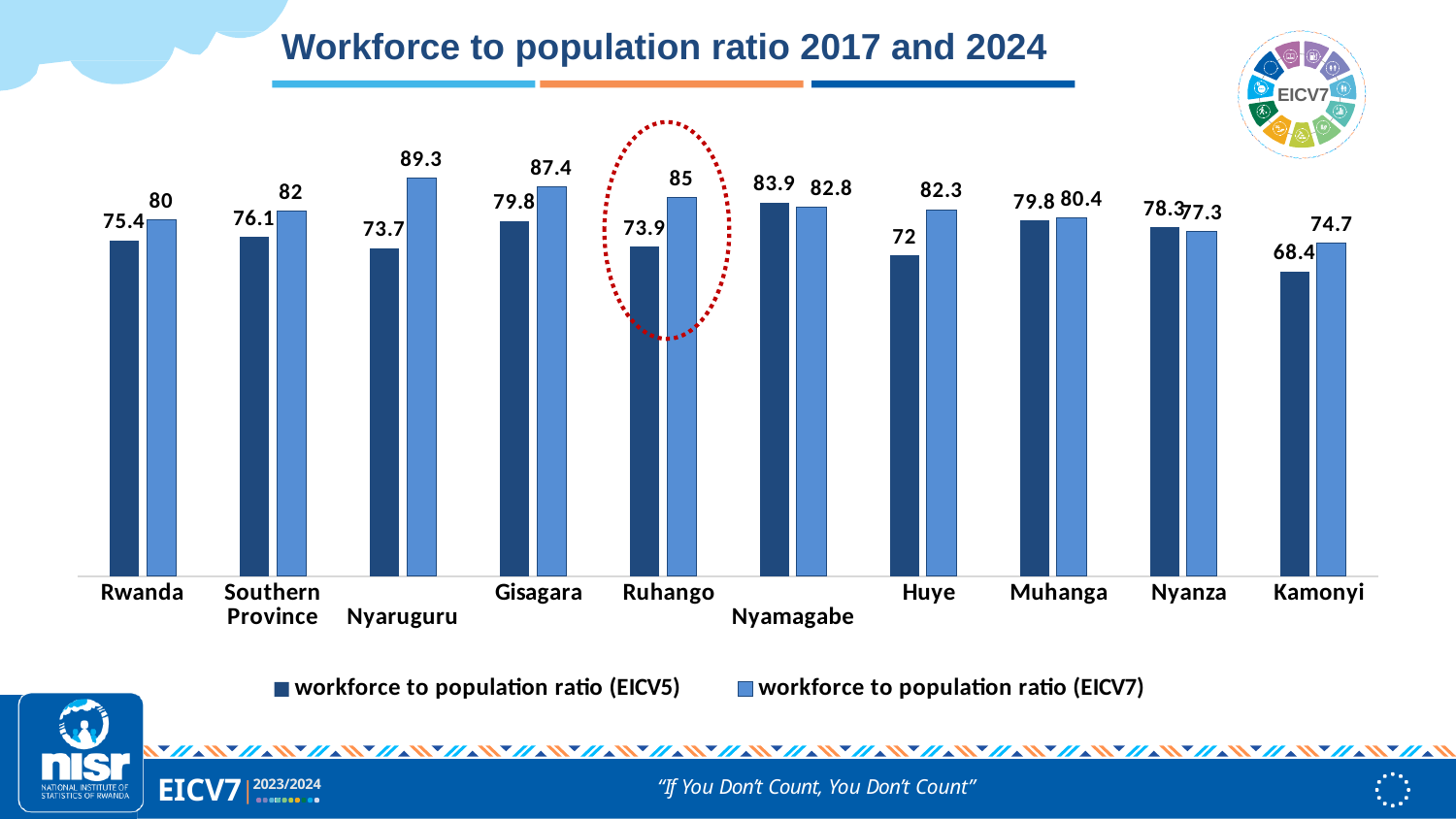
What kind of chart is shown on the slide? Bar chart For Nyamagabe, which is larger: the EICV5 ratio or the EICV7 ratio? EICV5 ratio What is the difference between the EICV7 and EICV5 workforce to population ratios for Ruhango? 11.1 What is the workforce to population ratio (EICV7) for Nyaruguru? 89.3 What is the title of the chart? Workforce to population ratio 2017 and 2024 How many categories are shown on the x axis? 10 What is the workforce to population ratio (EICV5) for Huye? 72 How many series does the legend list? 2 Which category has the highest workforce to population ratio (EICV7)? Nyaruguru Which category is highlighted with a red dotted circle? Ruhango What is the workforce to population ratio (EICV5) for Rwanda? 75.4 Which category has the lowest workforce to population ratio (EICV5)? Kamonyi